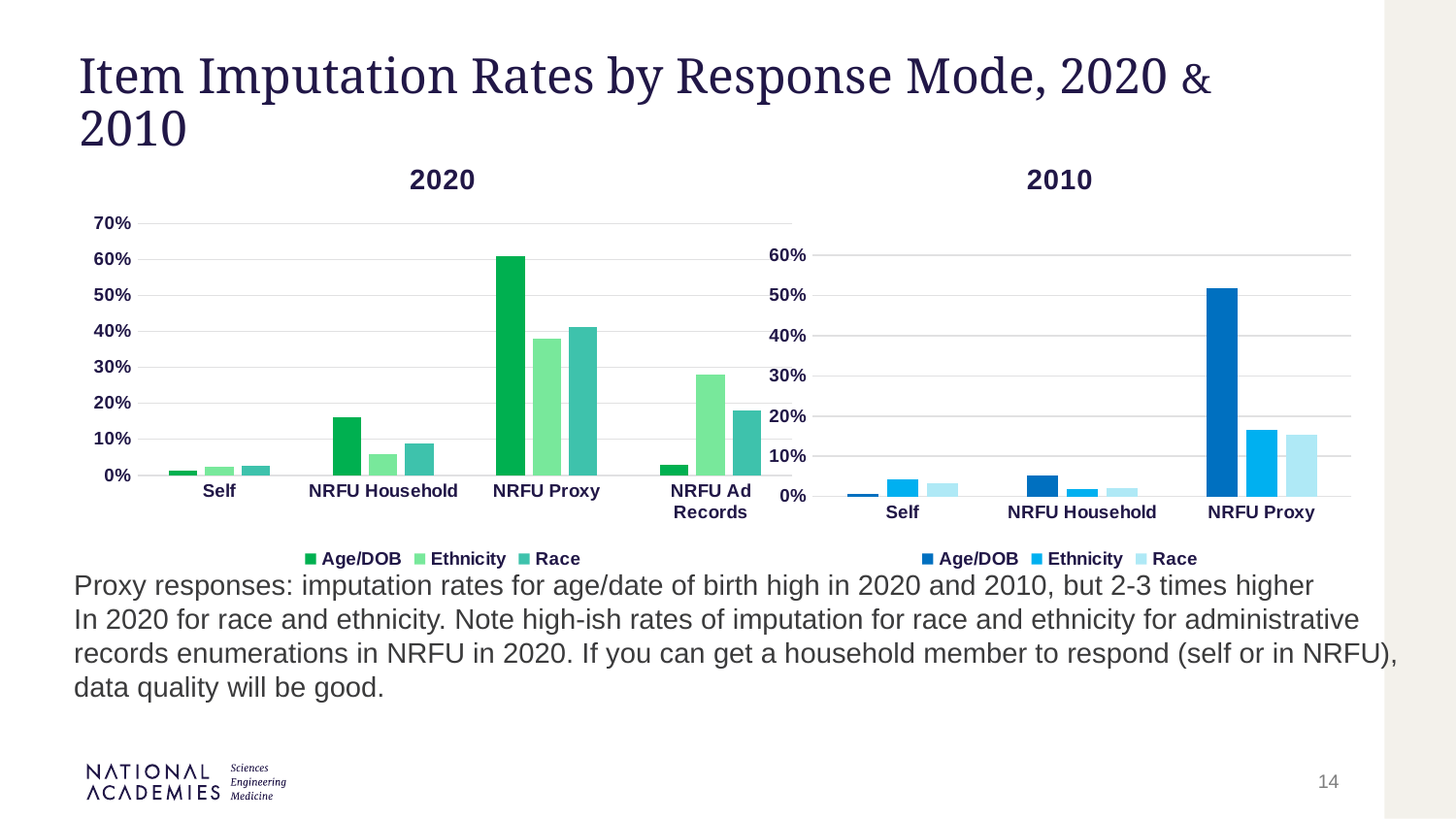
In the 2020 chart, which category has the highest Age/DOB imputation rate? NRFU Proxy What are the three series listed in the legend of the 2020 chart? Age/DOB, Ethnicity, Race In the 2010 chart, for NRFU Proxy, which is larger: the Age/DOB value or the Ethnicity value? Age/DOB How many response-mode categories are shown on the x axis of the 2010 chart? 3 In the 2010 chart, which category has the highest Age/DOB imputation rate? NRFU Proxy In the 2020 chart, is the Age/DOB value for NRFU Proxy greater or less than 50%? greater What kind of chart is the 2020 chart? bar chart In the 2010 chart, is the Age/DOB value for NRFU Proxy greater or less than 40%? greater How many response-mode categories are shown on the x axis of the 2020 chart? 4 In the 2020 chart, is the Ethnicity value for NRFU Ad Records greater or less than 20%? greater In the 2020 chart, which category has the lowest Age/DOB imputation rate? Self How many series does the legend of the 2010 chart list? 3